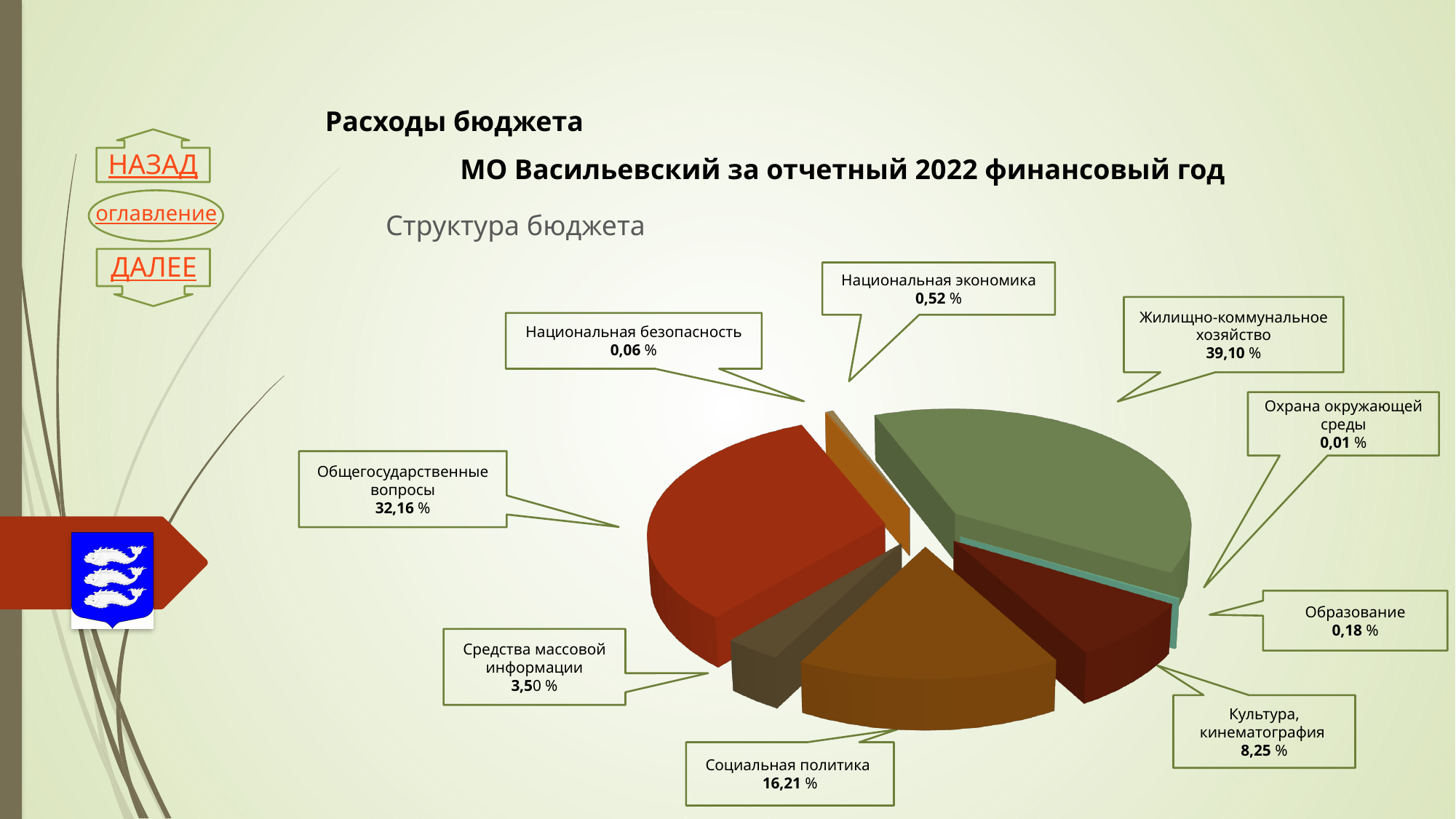
Which category has the largest share of the pie? Жилищно-коммунальное хозяйство What kind of chart is shown on the slide? Pie chart What is the value for Общегосударственные вопросы? 32,16 % Which category has the smallest share of the pie? Охрана окружающей среды What is the value for Средства массовой информации? 3,50 % What is the value for Национальная безопасность? 0,06 % What is the difference between the values for Жилищно-коммунальное хозяйство and Общегосударственные вопросы? 6,94 % Which is larger: Социальная политика or Культура, кинематография? Социальная политика What is the value for Культура, кинематография? 8,25 % What is the value for Жилищно-коммунальное хозяйство? 39,10 % What is the value for Социальная политика? 16,21 % How many categories are shown in the pie chart? 9